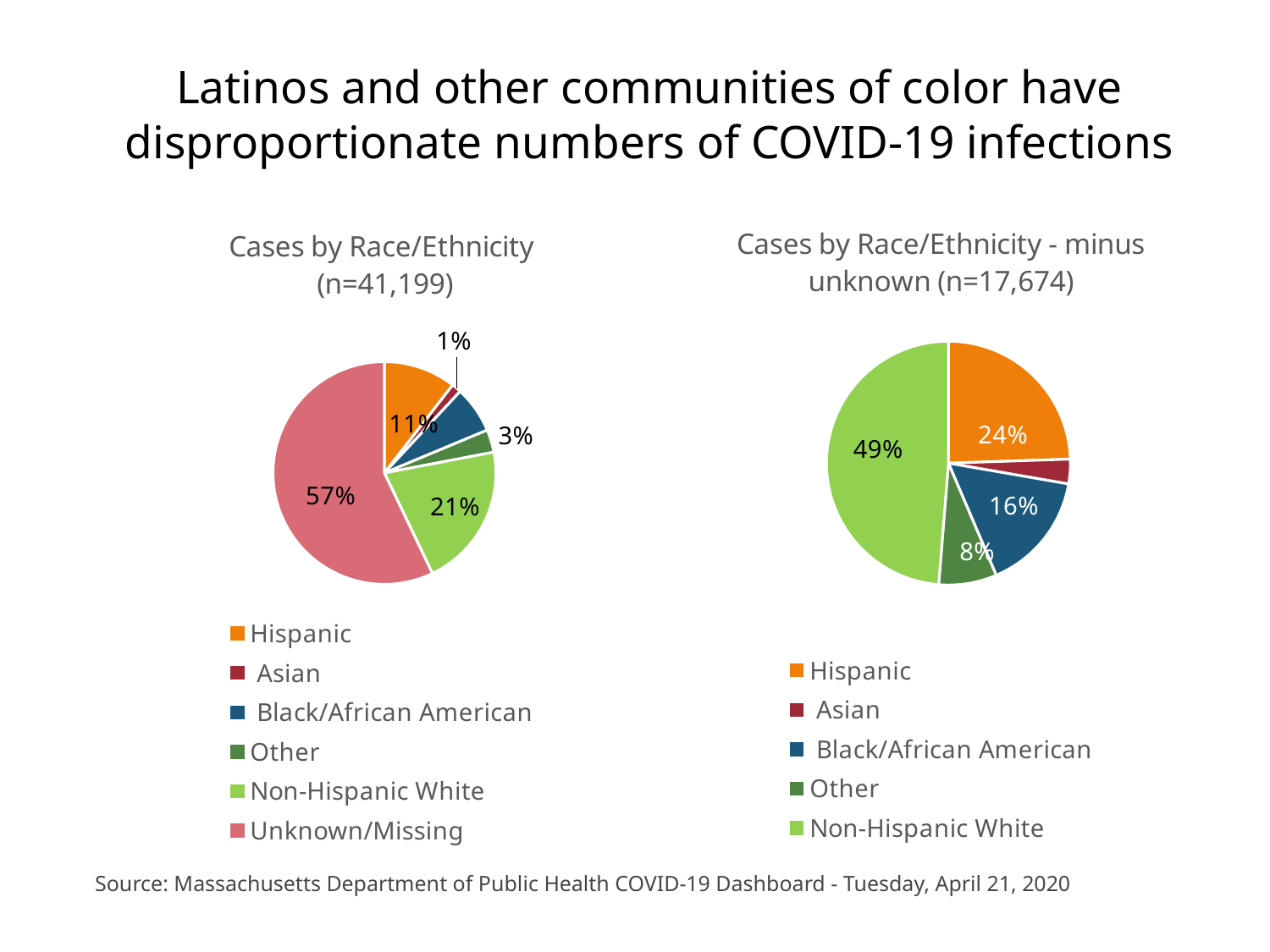
In the right pie chart (Cases by Race/Ethnicity - minus unknown, n=17,674), which category has the largest share? Non-Hispanic White In the right pie chart (Cases by Race/Ethnicity - minus unknown, n=17,674), what share of cases is Black/African American? 16% In the left pie chart (Cases by Race/Ethnicity, n=41,199), what share of cases is Other? 3% In the left pie chart (Cases by Race/Ethnicity, n=41,199), which category has the smallest share? Asian In the right pie chart (Cases by Race/Ethnicity - minus unknown, n=17,674), what is the difference between the Hispanic share and the Black/African American share? 8% In the left pie chart (Cases by Race/Ethnicity, n=41,199), what share of cases is Unknown/Missing? 57% In the left pie chart (Cases by Race/Ethnicity, n=41,199), what share of cases is Non-Hispanic White? 21% How many categories does the legend of the left pie chart (Cases by Race/Ethnicity, n=41,199) list? 6 In the right pie chart (Cases by Race/Ethnicity - minus unknown, n=17,674), what share of cases is Hispanic? 24% In the left pie chart (Cases by Race/Ethnicity, n=41,199), what share of cases is Asian? 1% In the right pie chart (Cases by Race/Ethnicity - minus unknown, n=17,674), what share of cases is Other? 8% What type of chart is used on this slide? Pie chart